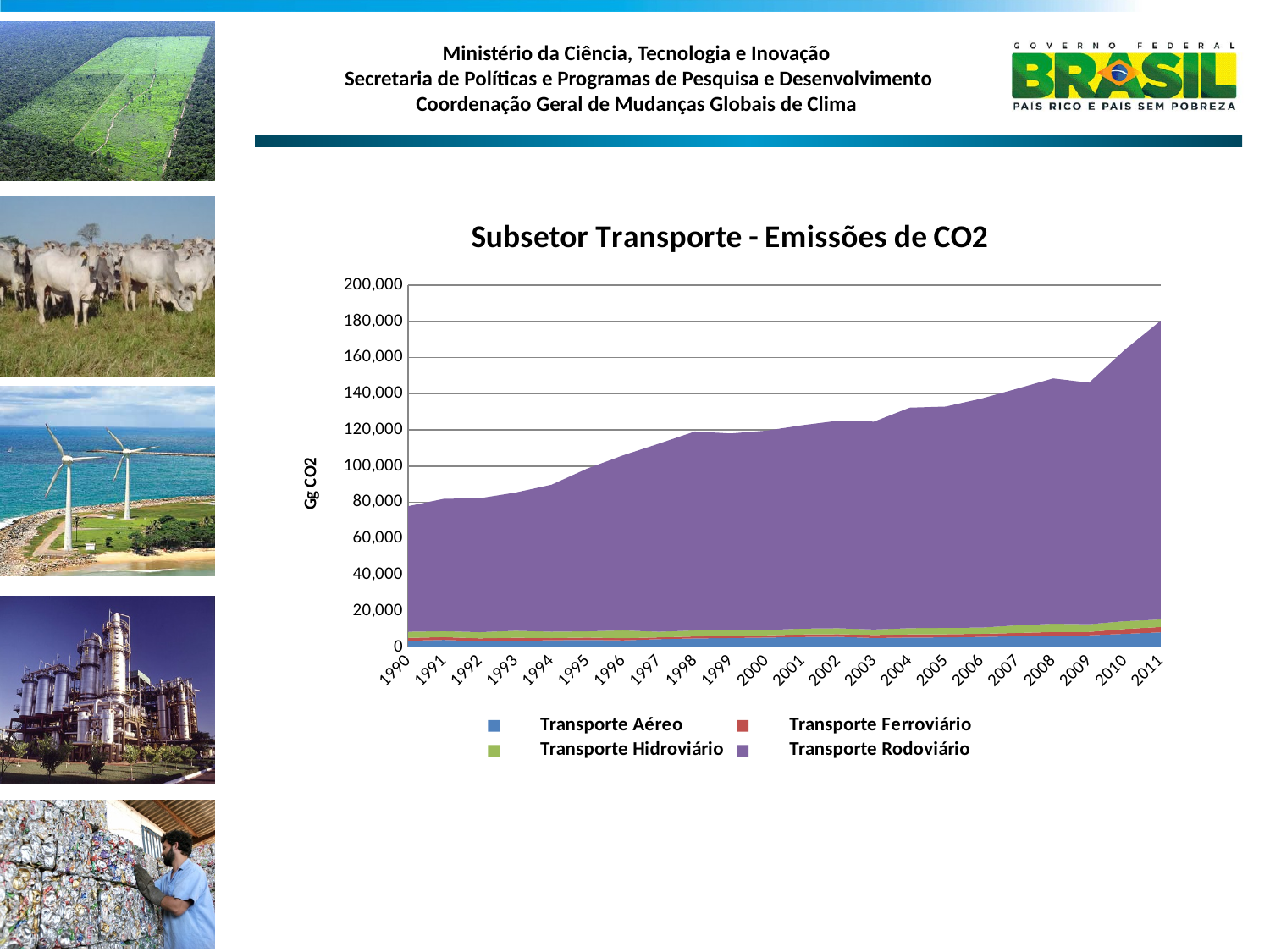
Which year has the lowest total CO2 emissions? 1990 Is the total emissions value for 2011 greater or less than 160,000? greater Do total CO2 emissions generally rise or fall from 1990 to 2011? rise What is the label of the y axis? Gg CO2 How many years are shown along the x axis? 22 Which year has the highest total CO2 emissions? 2011 Is the total emissions value for 1990 greater or less than 100,000? less How many series does the legend list? 4 What kind of chart is shown on the slide? Stacked area chart What is the title of the chart? Subsetor Transporte - Emissões de CO2 Which series accounts for the largest share of emissions in every year? Transporte Rodoviário Is the total emissions value for 2000 greater or less than 100,000? greater